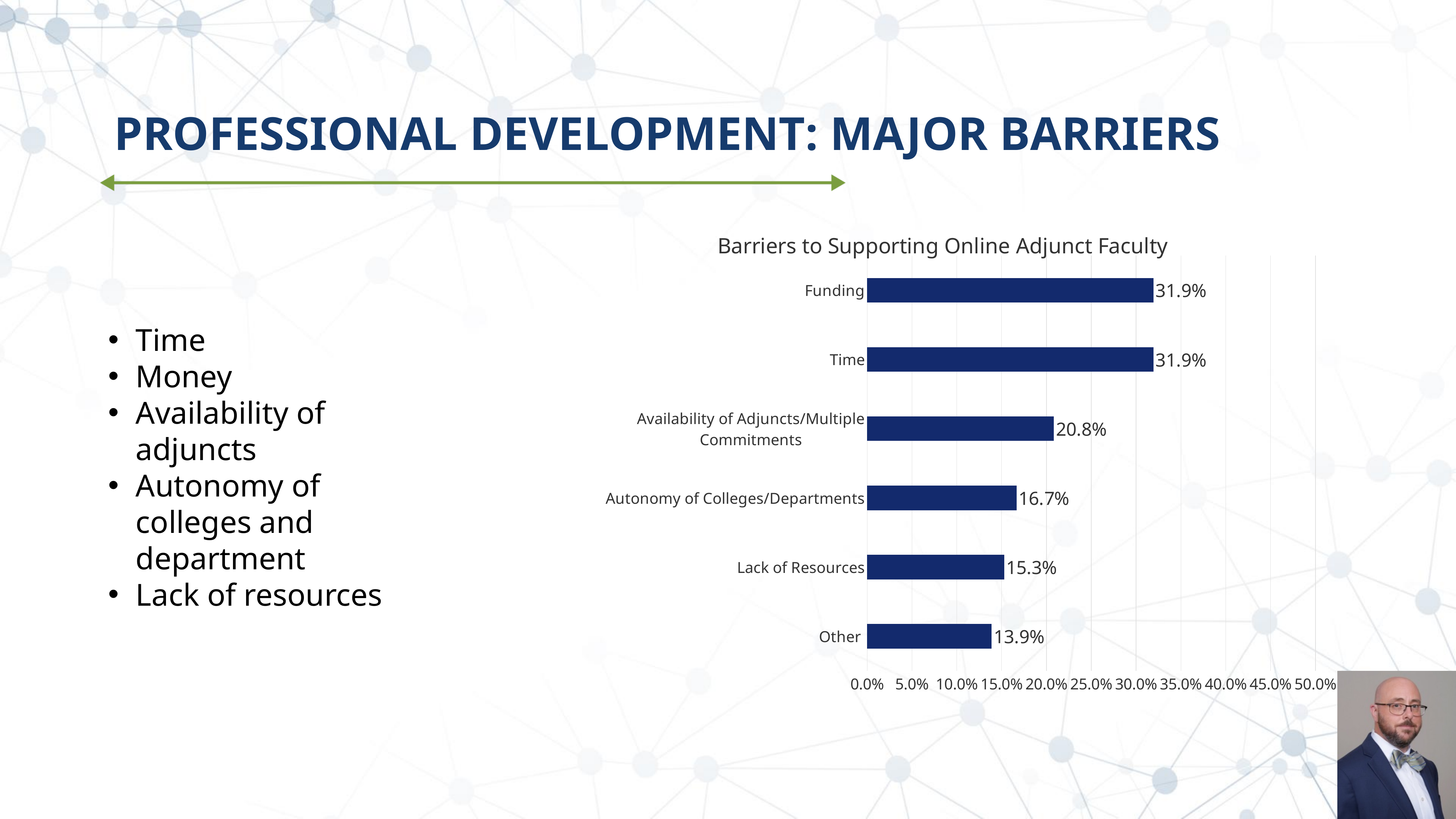
What is the difference between the values for Funding and Other? 18.0% How many categories are shown in the chart? 6 Which is larger, the value for Autonomy of Colleges/Departments or the value for Lack of Resources? Autonomy of Colleges/Departments What kind of chart is shown on the slide? Bar chart What is the title of the chart? Barriers to Supporting Online Adjunct Faculty What is the value for Availability of Adjuncts/Multiple Commitments? 20.8% What is the value for Lack of Resources? 15.3% What is the value for Autonomy of Colleges/Departments? 16.7% Is the value for Time greater or less than 30.0%? greater Which category has the lowest value? Other What is the value for Funding? 31.9% What is the difference between the values for Availability of Adjuncts/Multiple Commitments and Lack of Resources? 5.5%